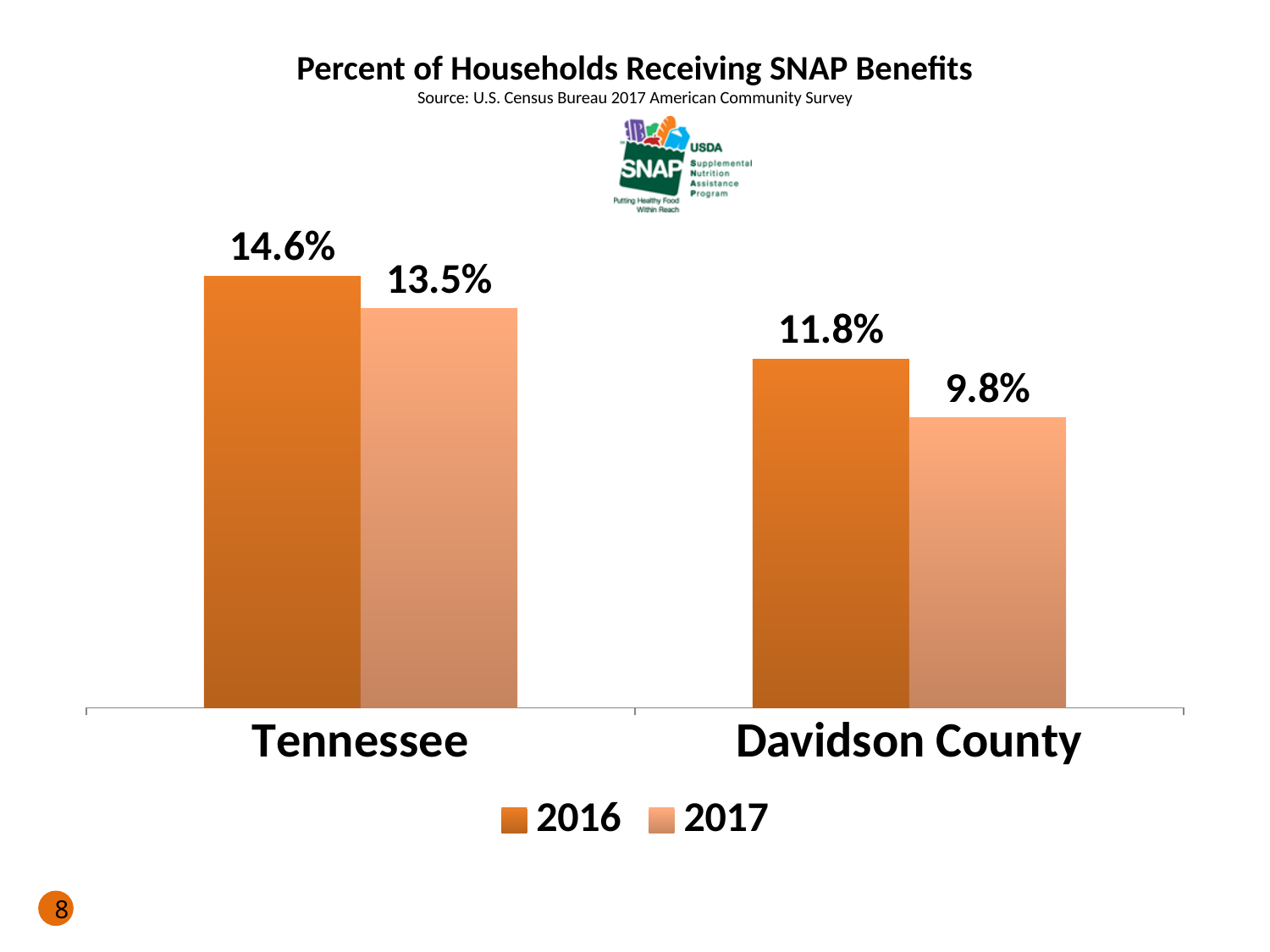
What percent of households in Tennessee received SNAP benefits in 2017? 13.5% What percent of households in Tennessee received SNAP benefits in 2016? 14.6% Which had a higher percent of households receiving SNAP benefits in 2017, Tennessee or Davidson County? Tennessee By how many percentage points did the Tennessee value fall from 2016 to 2017? 1.1 How many series does the legend list? 2 By how many percentage points did the Davidson County value fall from 2016 to 2017? 2.0 How many categories are shown on the x axis? 2 What kind of chart is shown on the slide? Bar chart Which bar shows the lowest value on the chart? Davidson County, 2017 What percent of households in Davidson County received SNAP benefits in 2016? 11.8% Which bar shows the highest value on the chart? Tennessee, 2016 What percent of households in Davidson County received SNAP benefits in 2017? 9.8%